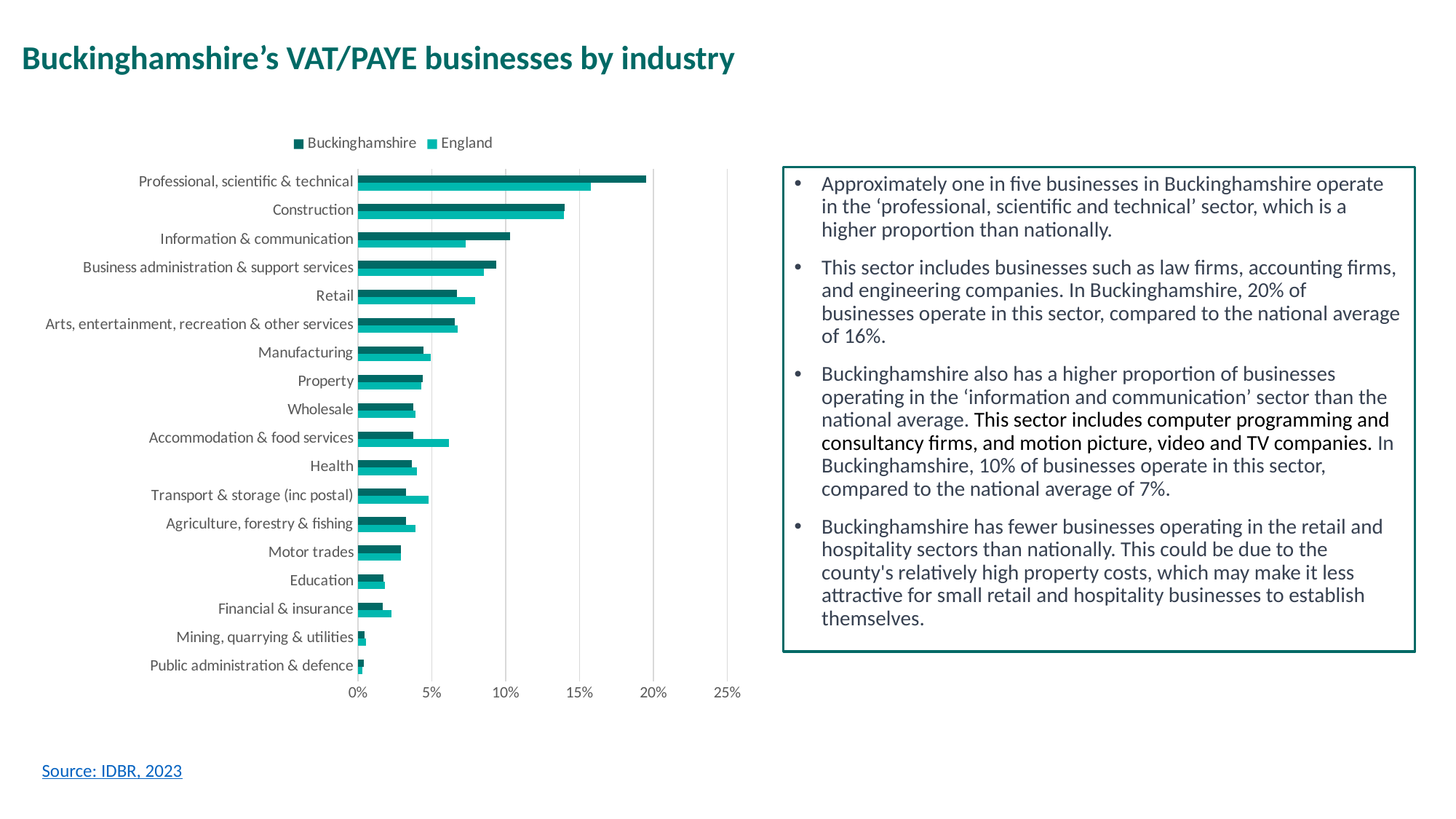
What kind of chart is shown on the slide? Bar chart Which industry has the highest Buckinghamshire value? Professional, scientific & technical For Accommodation & food services, which is larger: the Buckinghamshire value or the England value? England Is the Buckinghamshire value for Manufacturing greater or less than 5%? less Is the England value for Retail greater or less than 5%? greater What are the two series named in the chart legend? Buckinghamshire and England Is the Buckinghamshire value for Construction greater or less than 15%? less Which industry has the lowest Buckinghamshire value? Public administration & defence For Information & communication, which is larger: the Buckinghamshire value or the England value? Buckinghamshire How many series does the legend list? 2 How many industry categories are plotted on the chart? 18